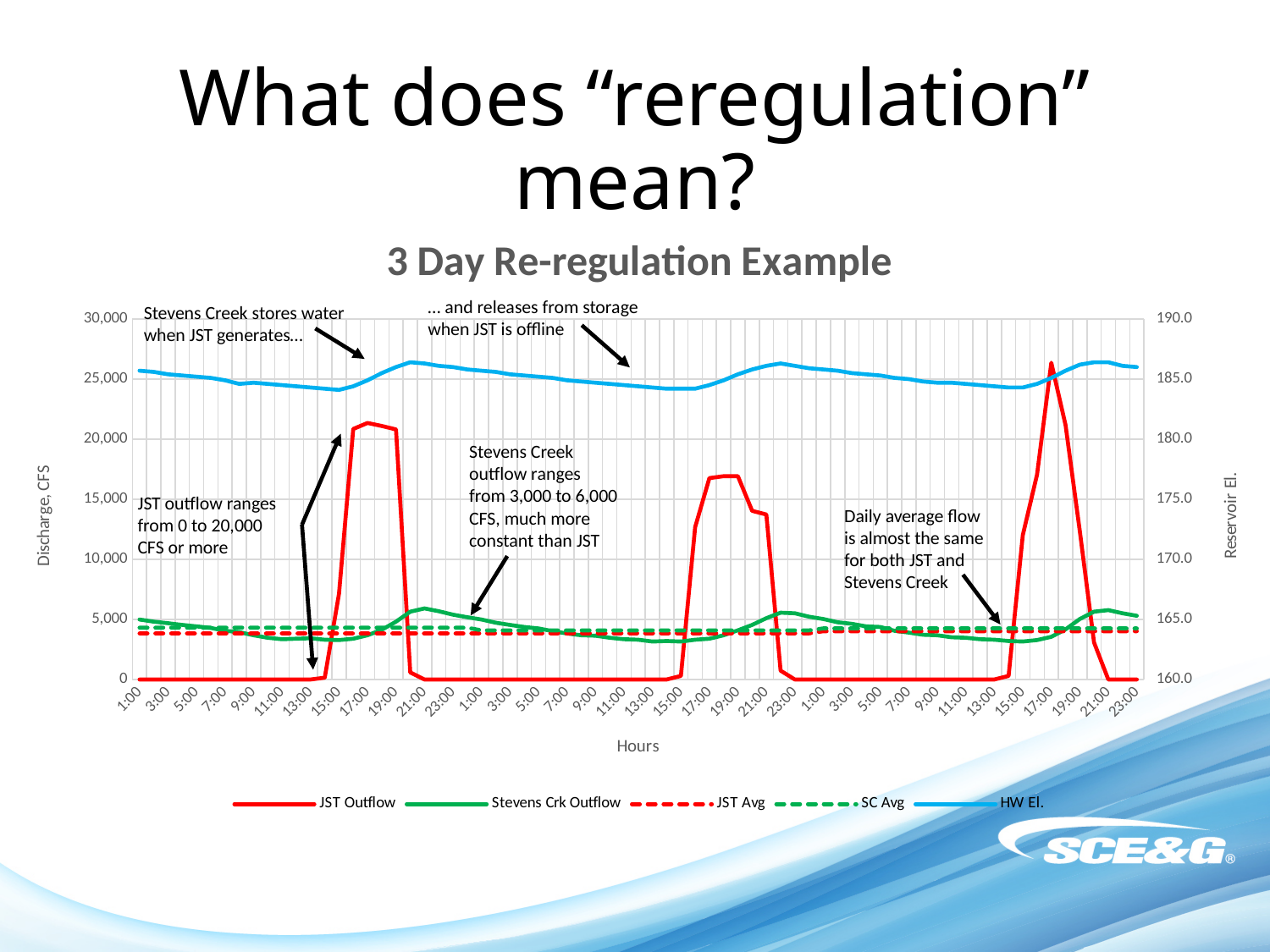
Which series reaches the highest discharge value on the chart? JST Outflow What kind of chart is shown on the slide? Line chart On which of the three days does the JST Outflow series reach its highest peak? The third day Is the peak of the JST Outflow series on the second day greater or less than 20,000? less What is the title of the chart? 3 Day Re-regulation Example Is the highest value of the JST Outflow series greater or less than 20,000? greater Is the JST Avg line greater or less than 5,000? less What is the label of the horizontal axis? Hours How many series does the legend list? 5 Which series has the higher peak value, JST Outflow or Stevens Crk Outflow? JST Outflow